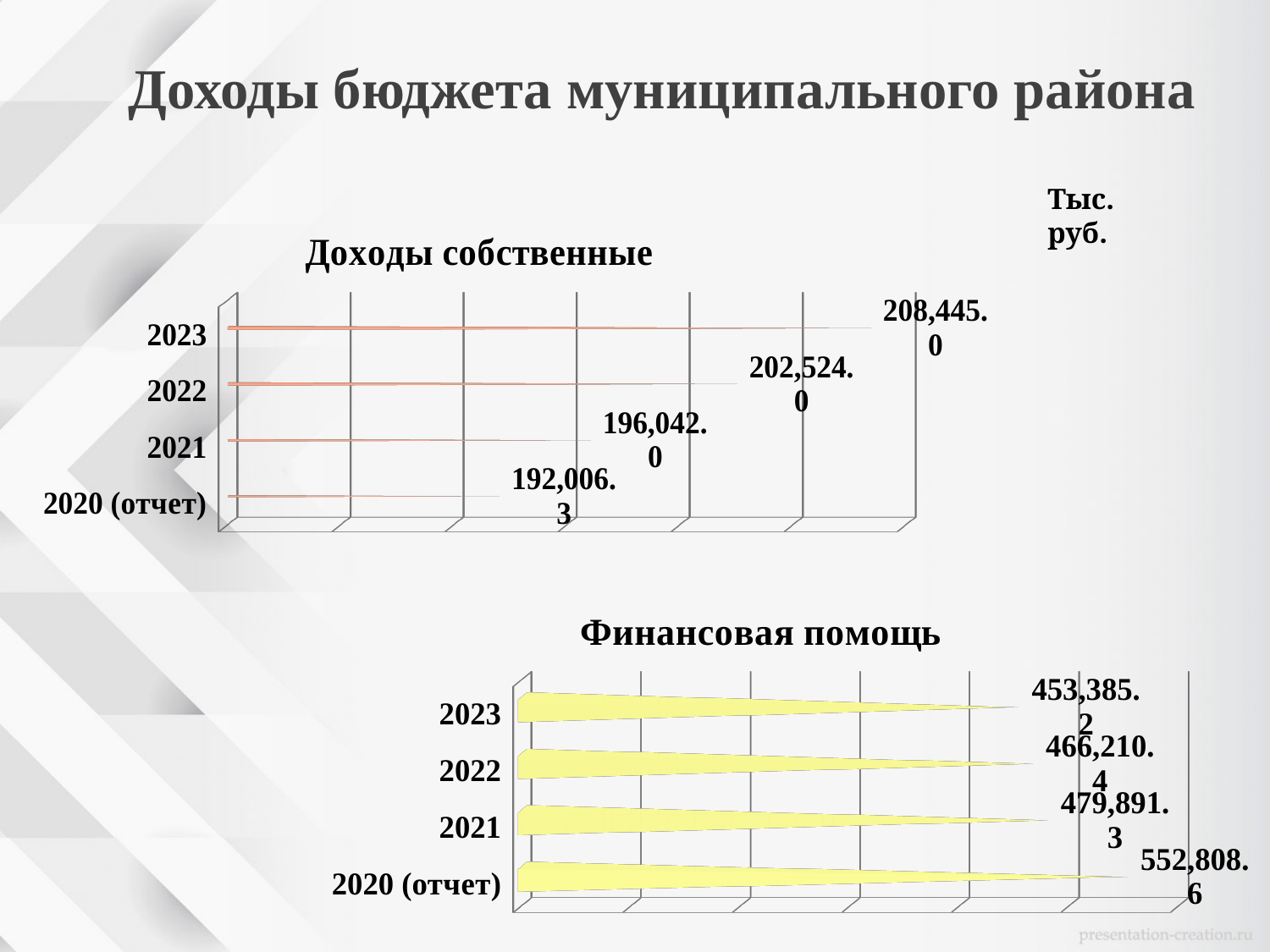
How many categories are shown in the 'Финансовая помощь' chart? 4 In the 'Финансовая помощь' chart, what is the value for 2022? 466,210.4 In the 'Финансовая помощь' chart, what is the difference between the 2020 (отчет) value and the 2023 value? 99,423.4 In the 'Доходы собственные' chart, what is the value for 2020 (отчет)? 192,006.3 In the 'Доходы собственные' chart, do the values rise or fall from 2020 (отчет) to 2023? rise In the 'Финансовая помощь' chart, what is the value for 2021? 479,891.3 In the 'Финансовая помощь' chart, which year has the highest value? 2020 (отчет) In the 'Финансовая помощь' chart, which year has the lowest value? 2023 In the 'Доходы собственные' chart, what is the value for 2023? 208,445.0 In the 'Доходы собственные' chart, which year has the highest value? 2023 What kind of chart is the 'Финансовая помощь' chart? bar chart In the 'Доходы собственные' chart, what is the difference between the 2023 value and the 2020 (отчет) value? 16,438.7